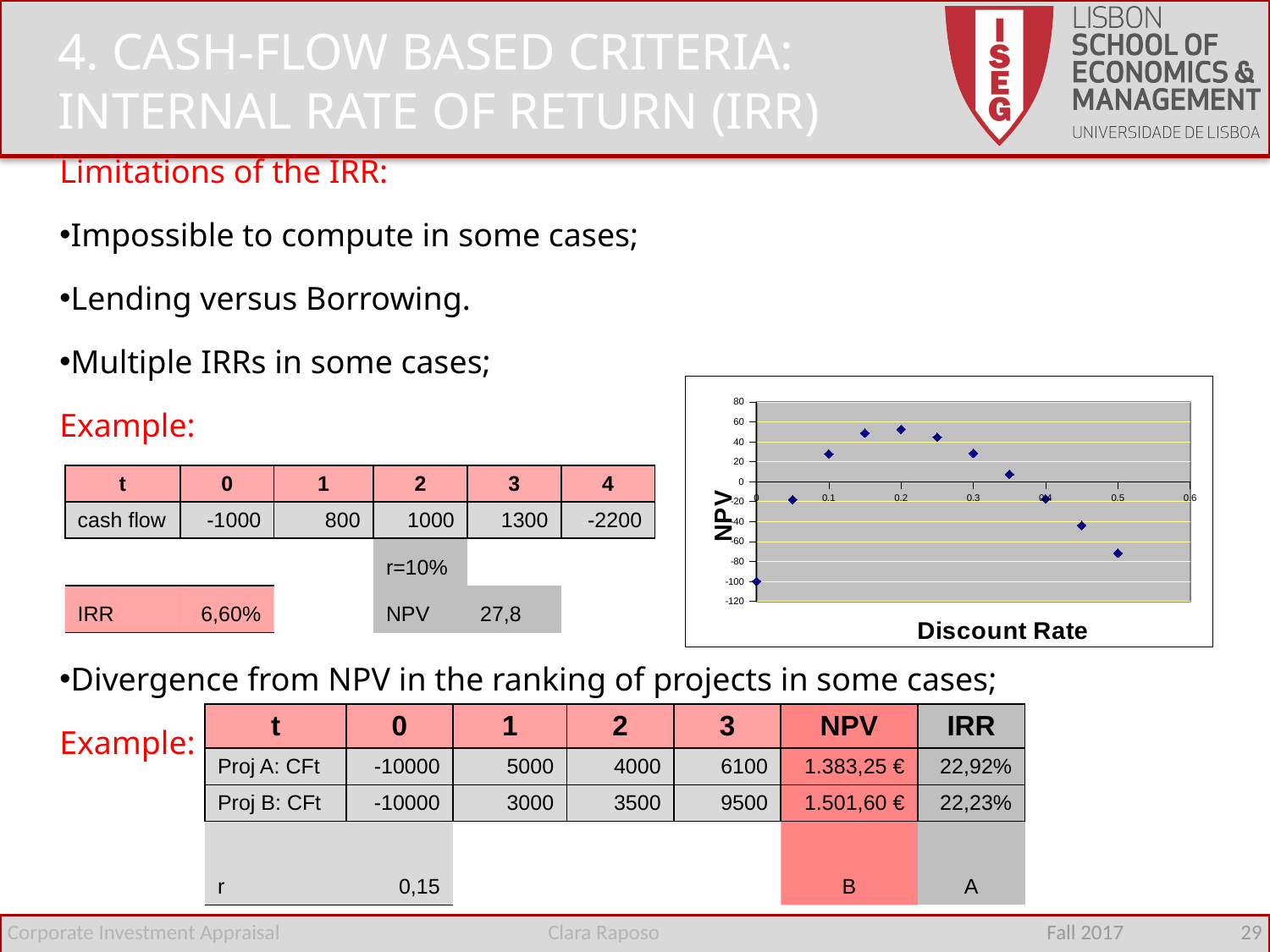
Which is larger, the NPV at a discount rate of 0.15 or at 0.35? 0.15 What is the title of the horizontal axis of the chart? Discount Rate Do the plotted NPV values rise or fall as the discount rate increases from 0.2 to 0.5? fall At which discount rate is the plotted NPV lowest? 0 Is the NPV at a discount rate of 0.5 greater or less than -60? less Is the NPV at a discount rate of 0.2 greater or less than 40? greater Which is larger, the NPV at a discount rate of 0.4 or at 0.5? 0.4 How many data points are plotted in the chart? 11 What kind of chart is shown on the slide? scatter chart Is the NPV at a discount rate of 0.45 greater or less than -20? less What is the NPV plotted at a discount rate of 0? -100 What is the title of the vertical axis of the chart? NPV